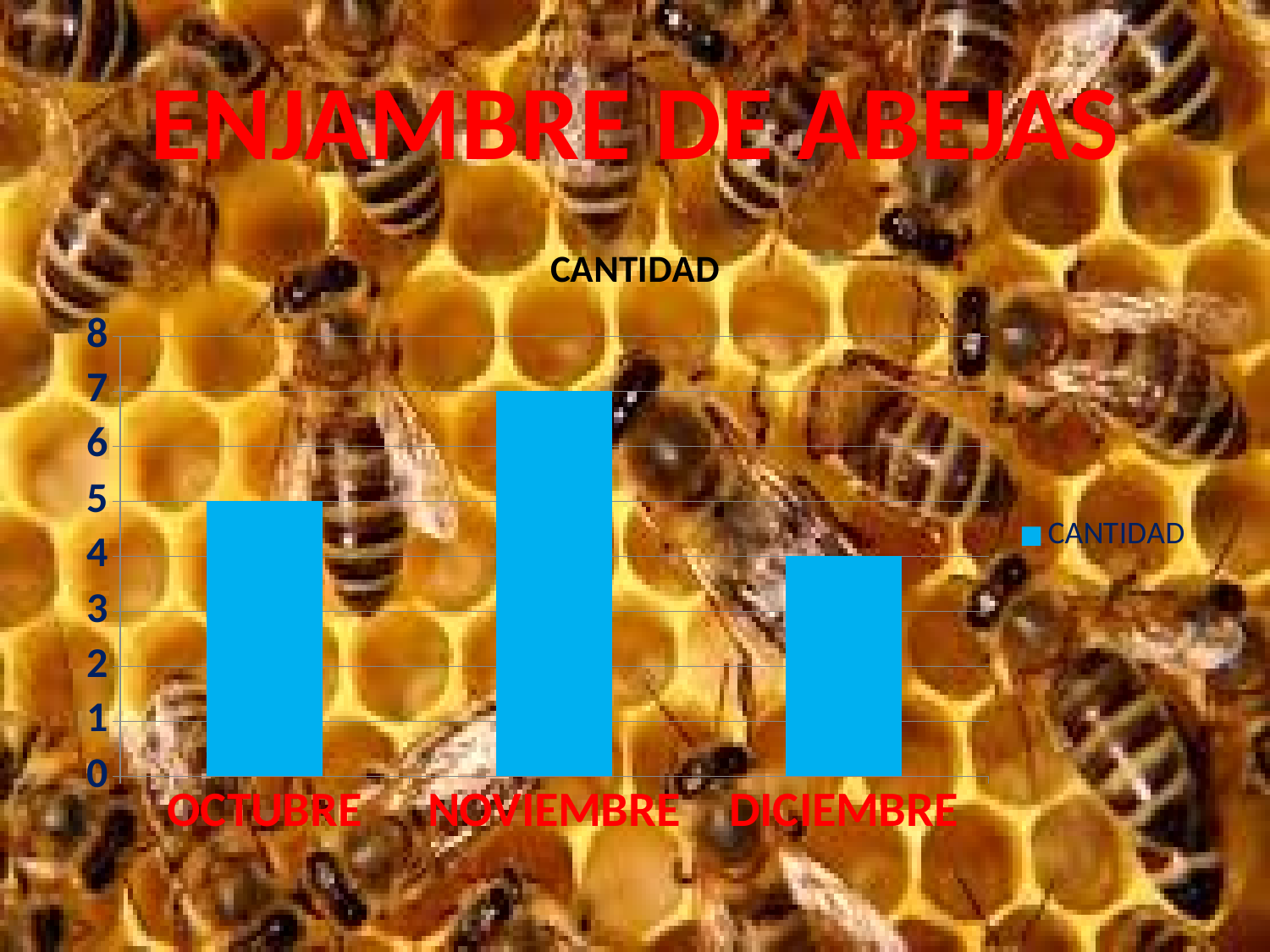
Which month has the highest value? NOVIEMBRE What type of chart is shown on the slide? bar chart What is the difference between the values for NOVIEMBRE and OCTUBRE? 2 What is the title of the chart? CANTIDAD Is the value for NOVIEMBRE greater or less than 6? greater What is the value for NOVIEMBRE? 7 Which is larger, the value for OCTUBRE or the value for DICIEMBRE? OCTUBRE What is the value for DICIEMBRE? 4 What is the value for OCTUBRE? 5 Which month has the lowest value? DICIEMBRE How many categories are shown on the x axis of the chart? 3 How many series does the legend list? 1